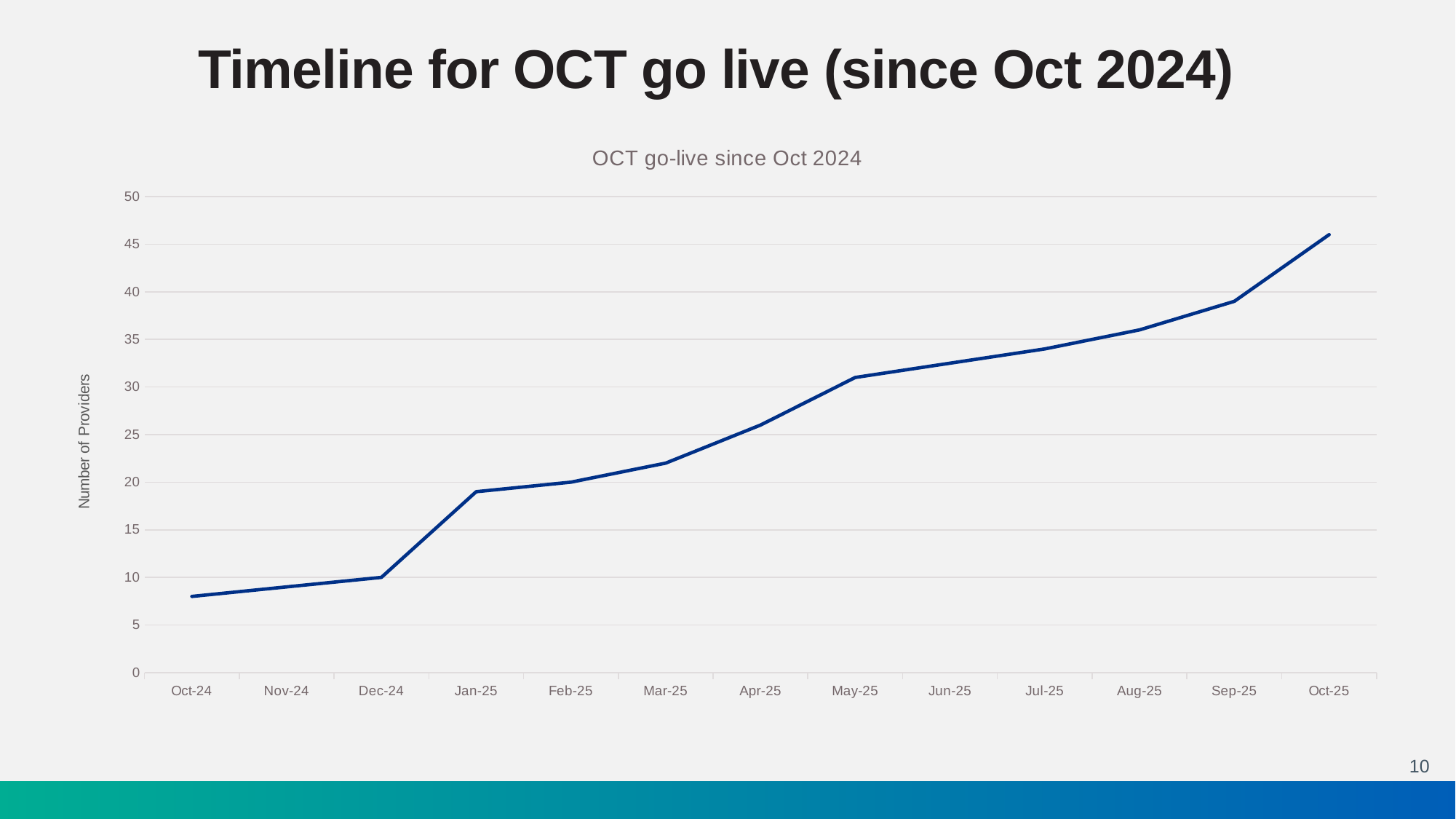
What kind of chart is shown on the slide? line chart Which month has the lowest number of providers? Oct-24 Do the values rise or fall from Oct-24 to Oct-25? rise Is the value for May-25 greater or less than 30? greater Which is larger, the value for Jan-25 or the value for Apr-25? Apr-25 Which month has the highest number of providers? Oct-25 What is the label on the vertical axis? Number of Providers What is the number of providers in Dec-24? 10 How many months are plotted along the x axis? 13 What is the title of the chart? OCT go-live since Oct 2024 Is the value for Oct-24 greater or less than 10? less Is the value for Oct-25 greater or less than 40? greater